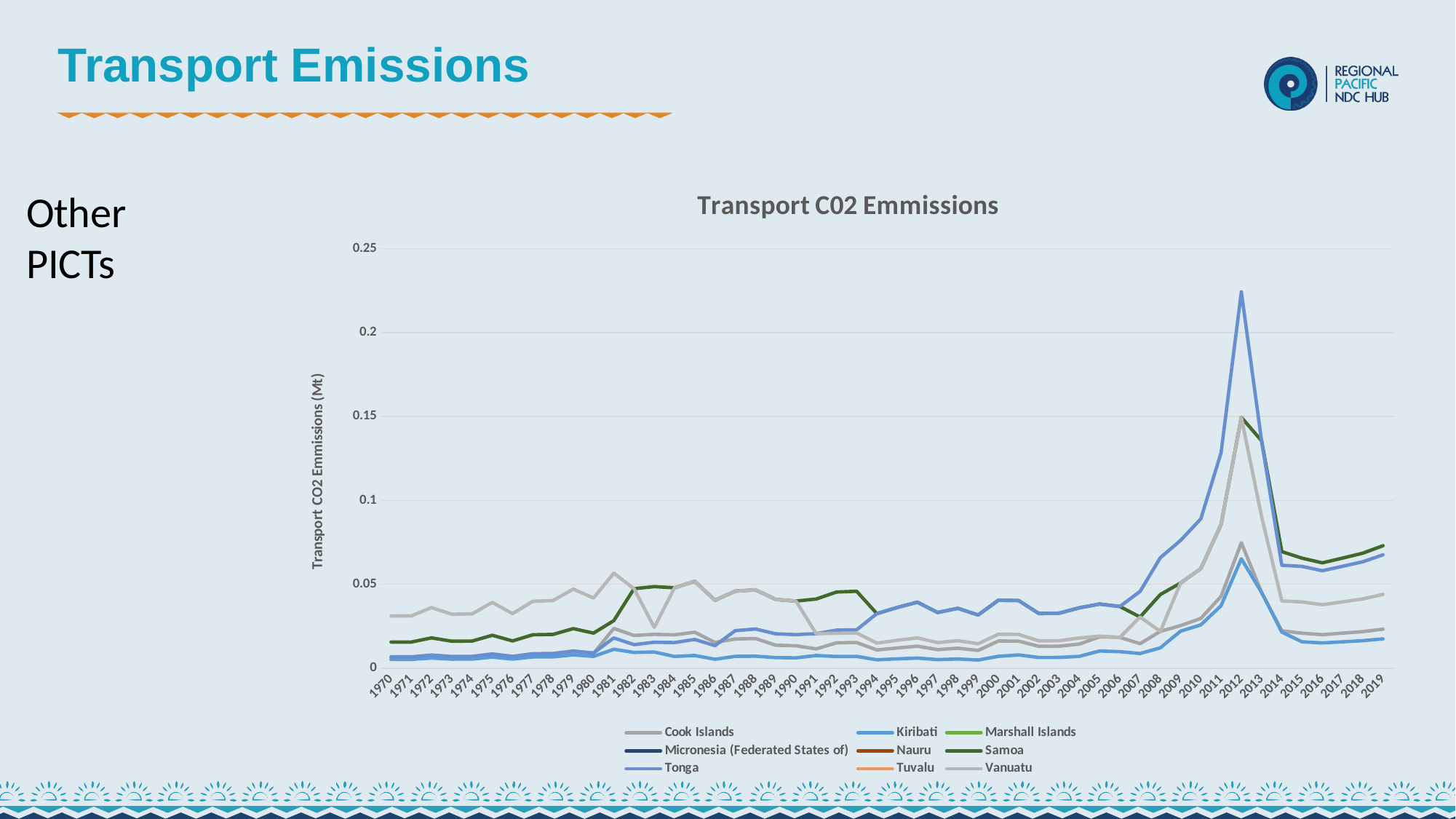
In which year does the Tonga series reach its peak? 2012 Which series reaches the highest value on the chart? Tonga What is the label of the vertical axis? Transport CO2 Emmissions (Mt) Which is larger in 2019, the value for Samoa or the value for Kiribati? Samoa What kind of chart is shown on the slide? line chart Does the Tonga series rise or fall between 2012 and 2014? fall What is the title of the chart? Transport C02 Emmissions Is the value for Tonga in 2012 greater or less than 0.2? greater Is the value for Samoa in 2012 greater or less than 0.1? greater Is the value for Kiribati in 2019 greater or less than 0.05? less How many years are plotted along the x axis of the chart? 50 How many series does the chart legend list? 9